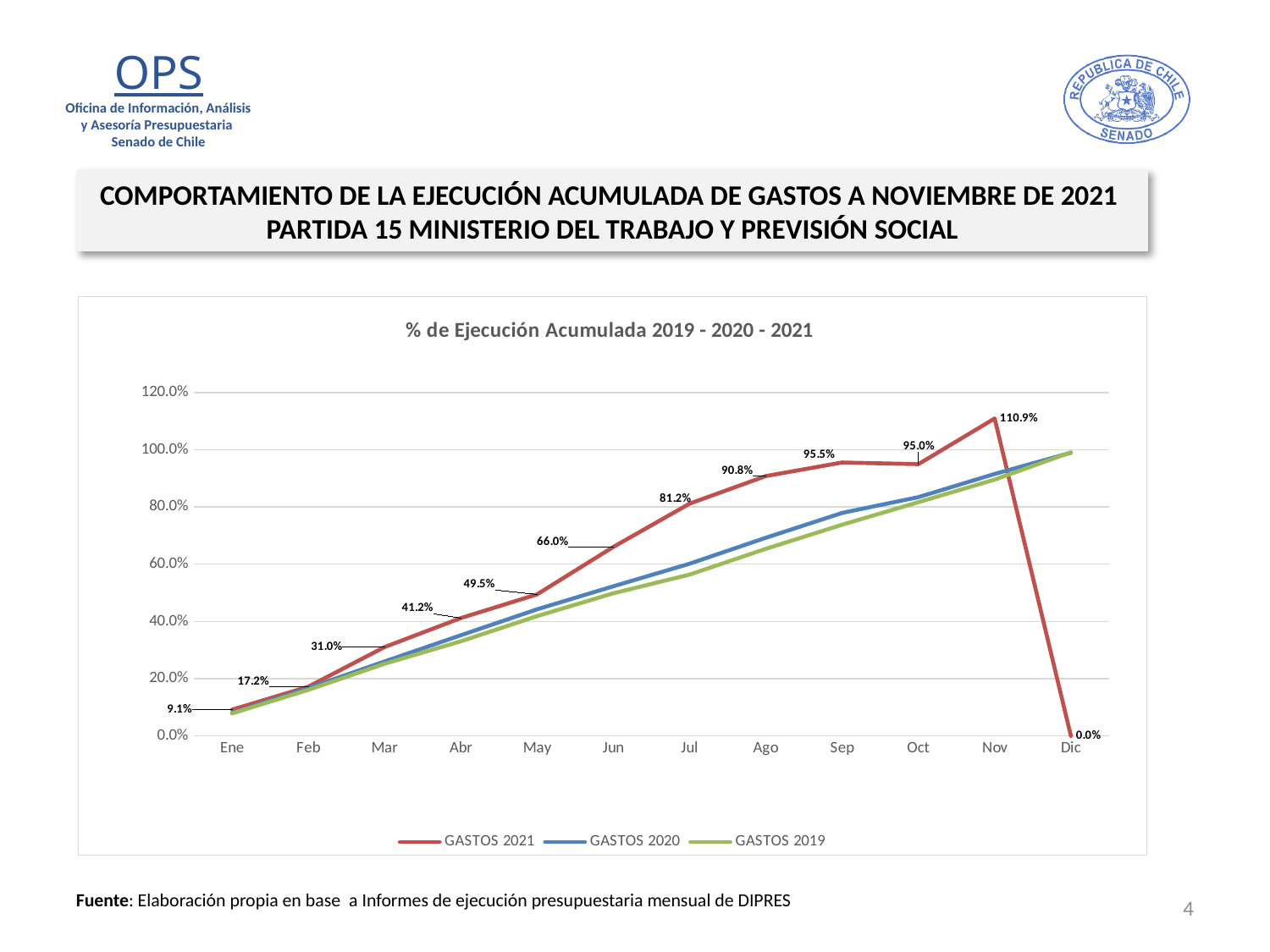
How many series does the legend list? 3 In which month does GASTOS 2021 reach its highest value? Nov What kind of chart is shown? line chart How many months are shown on the x axis? 12 In which month is the GASTOS 2021 value lowest? Dic What is the difference between the GASTOS 2021 values for Nov and Oct? 15.9% Is the value for GASTOS 2020 in Sep greater or less than 60.0%? greater What is the value for GASTOS 2021 in Mar? 31.0% What is the value for GASTOS 2021 in Jul? 81.2% Which is larger for GASTOS 2021: the value in Sep or the value in Oct? Sep What is the title of the chart? % de Ejecución Acumulada 2019 - 2020 - 2021 What is the value for GASTOS 2021 in Ene? 9.1%